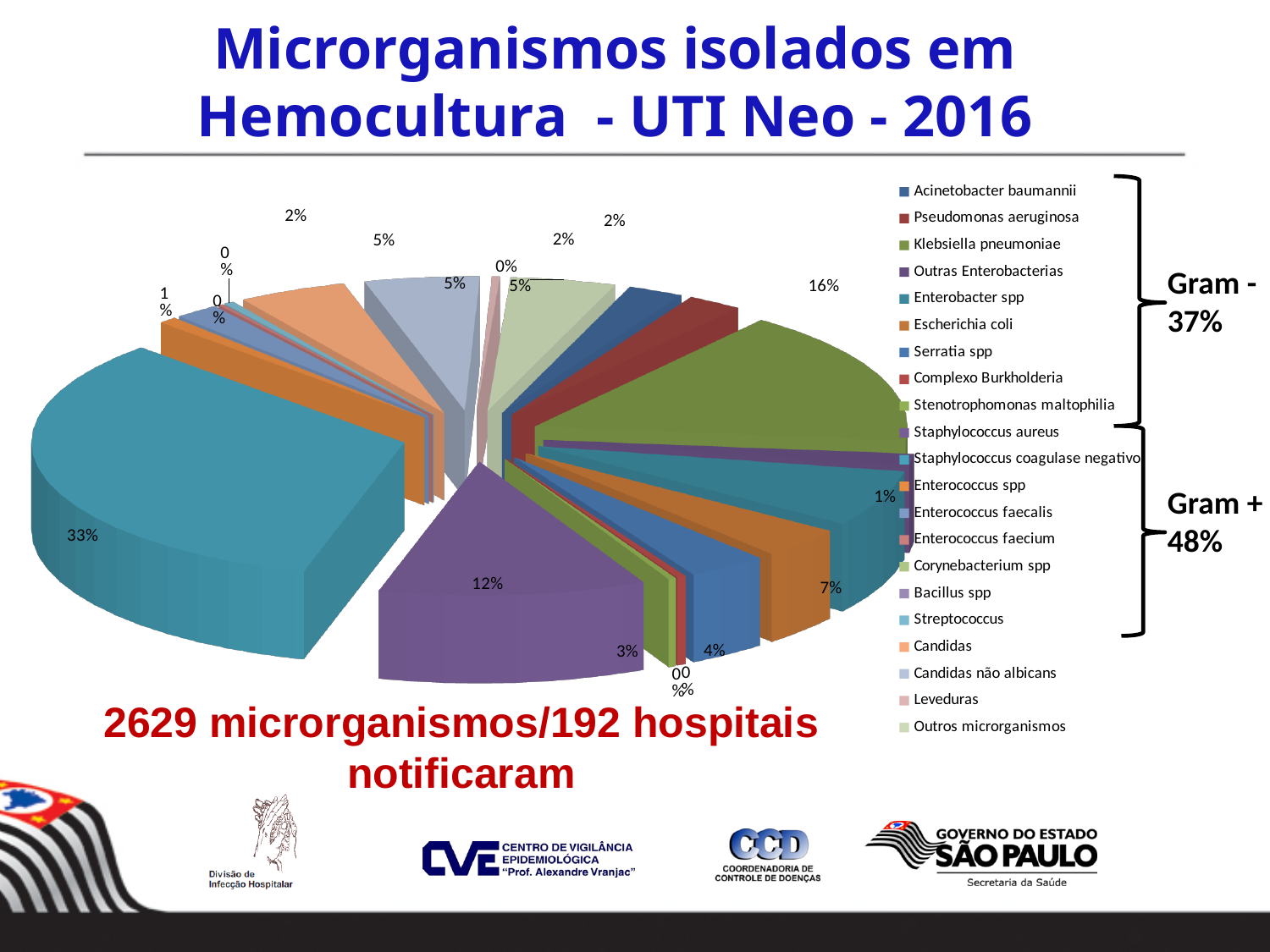
What is the title of the chart on the slide? Microrganismos isolados em Hemocultura - UTI Neo - 2016 What kind of chart is shown on the slide? pie chart According to the annotation beside the legend, what percentage of isolates are Gram-negative (Gram -)? 37% Which is larger, the slice for Staphylococcus coagulase negativo or the slice for Klebsiella pneumoniae? Staphylococcus coagulase negativo According to the annotation beside the legend, what percentage of isolates are Gram-positive (Gram +)? 48% Which is larger, the Gram + share or the Gram - share? Gram + What is the difference in percentage points between the Staphylococcus coagulase negativo slice (33%) and the Klebsiella pneumoniae slice (16%)? 17 percentage points Which microorganism has the largest share of the pie chart? Staphylococcus coagulase negativo How many microorganism categories does the legend list? 21 What share of the pie does Staphylococcus aureus represent? 12% What is the percentage of the largest slice in the pie chart? 33% What share of the pie does Klebsiella pneumoniae represent? 16%